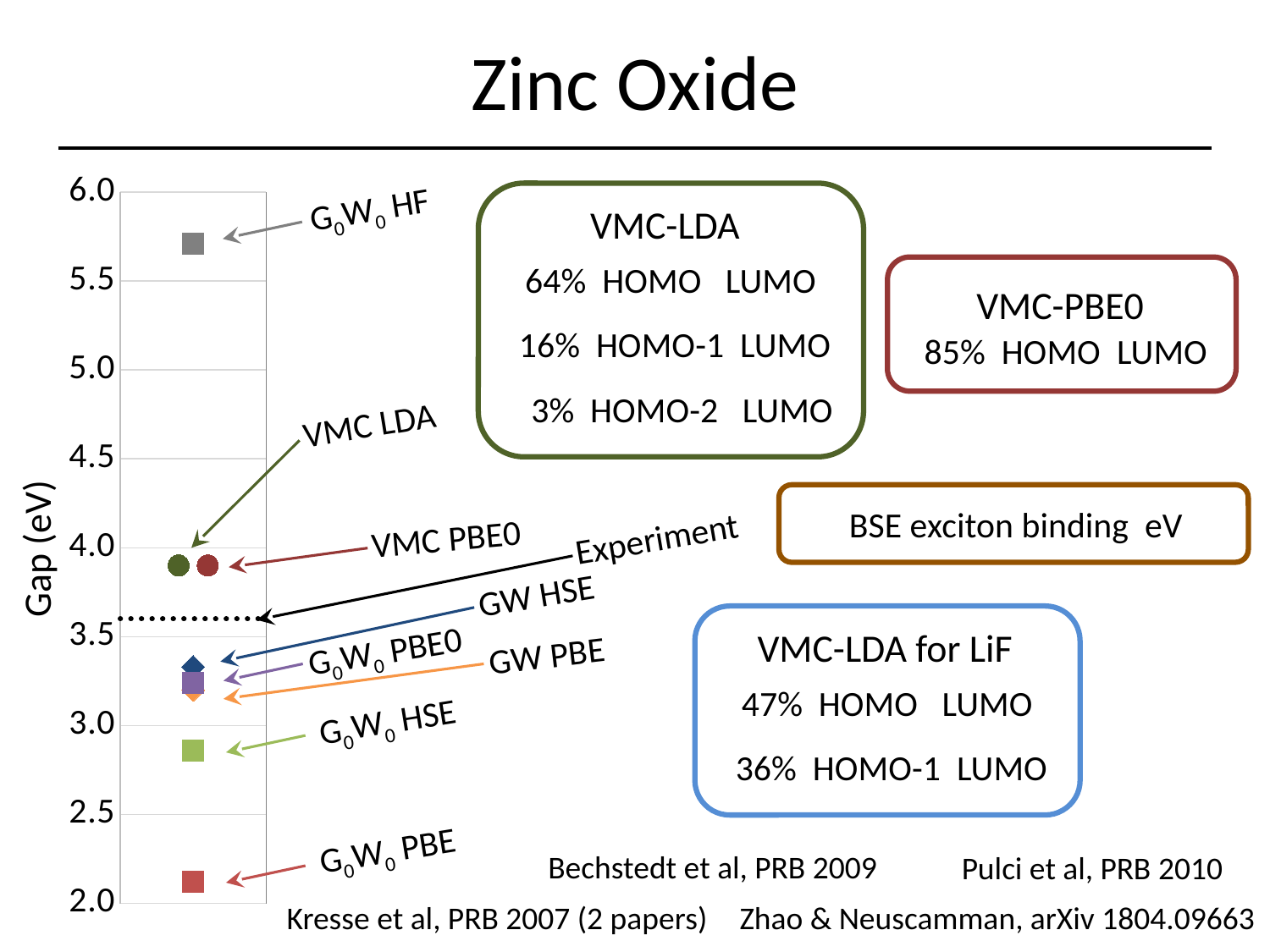
Is the gap value for G0W0 HSE greater or less than 3.0? less Is the gap value for VMC LDA greater or less than 3.5? greater Which method has the lowest gap value plotted on the chart? G0W0 PBE Is the gap value for G0W0 PBE greater or less than 2.5? less Which has a larger gap value, G0W0 HSE or G0W0 PBE? G0W0 HSE Which method has the highest gap value plotted on the chart? G0W0 HF What kind of chart is shown on the slide? scatter chart What is the label of the y axis of the chart? Gap (eV) What is the title of the slide containing the chart? Zinc Oxide Which has a larger gap value, VMC PBE0 or GW HSE? VMC PBE0